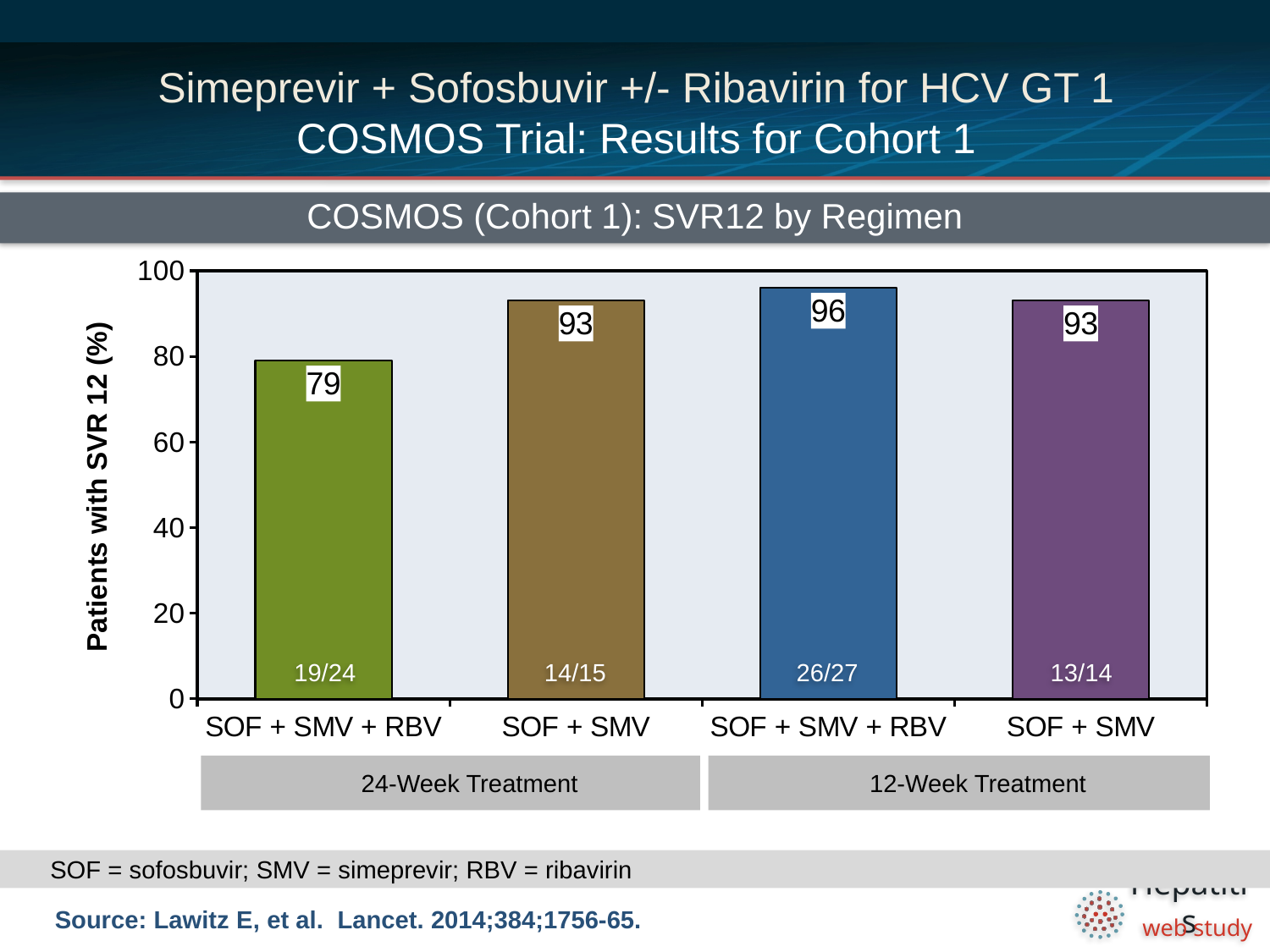
What is the SVR12 rate for SOF + SMV in the 12-Week Treatment group? 93 Is the SVR12 rate for the 24-Week SOF + SMV + RBV group greater or less than 80? less What is the difference in SVR12 rate between the 12-Week SOF + SMV + RBV group and the 24-Week SOF + SMV + RBV group? 17 What is the title of the chart? COSMOS (Cohort 1): SVR12 by Regimen How many bars are shown in the chart? 4 What is the SVR12 rate for SOF + SMV + RBV in the 24-Week Treatment group? 79 How many patients achieved SVR12 out of the total in the 24-Week SOF + SMV + RBV group, as printed on the bar? 19/24 Which has a higher SVR12 rate: 24-Week SOF + SMV or 24-Week SOF + SMV + RBV? 24-Week SOF + SMV Which regimen and treatment duration has the highest SVR12 rate? SOF + SMV + RBV, 12-Week Treatment What is the SVR12 rate for SOF + SMV + RBV in the 12-Week Treatment group? 96 What type of chart is shown on the slide? bar chart Which regimen and treatment duration has the lowest SVR12 rate? SOF + SMV + RBV, 24-Week Treatment